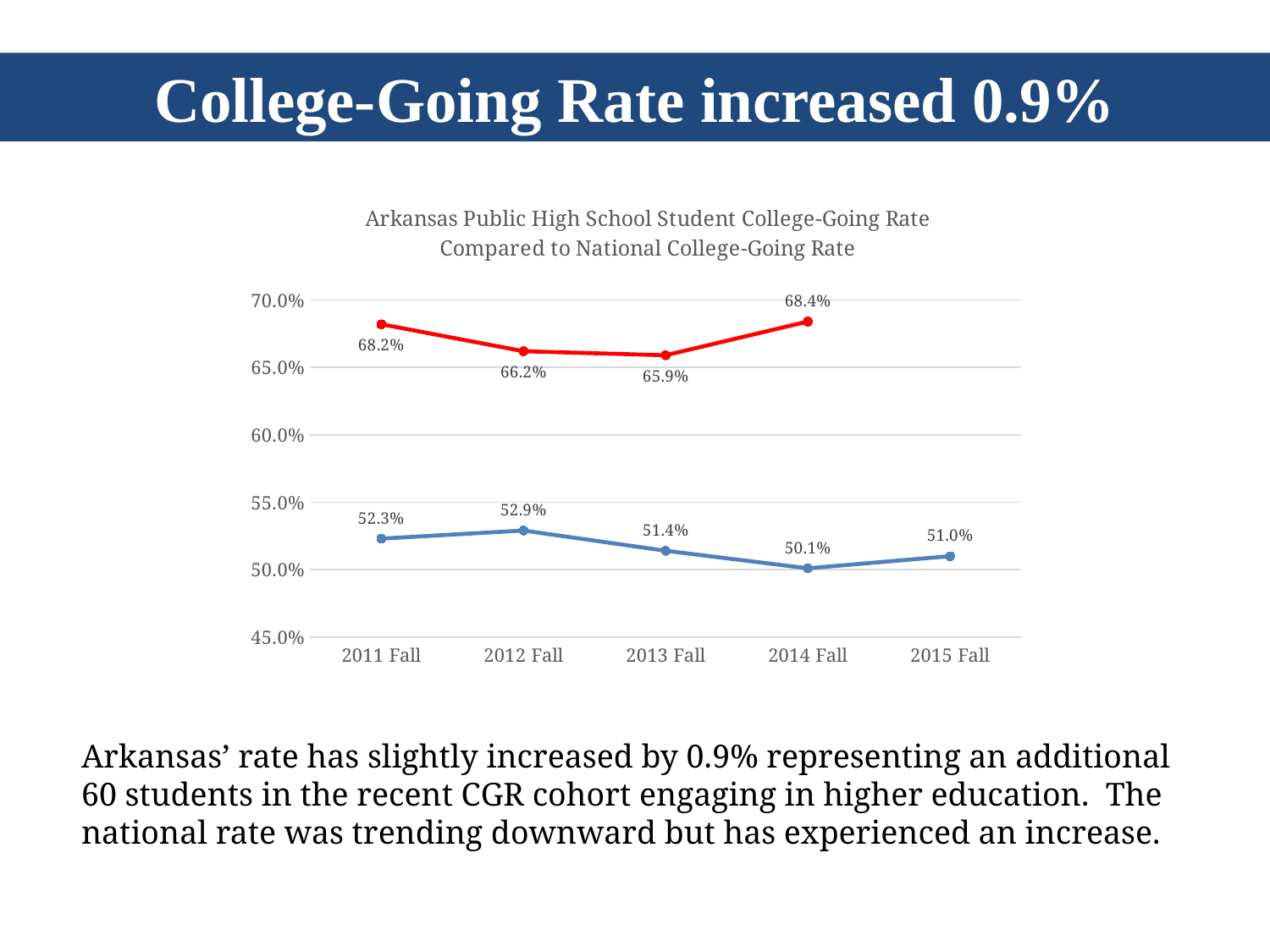
What is the difference between the red line's values for 2011 Fall and 2013 Fall? 2.3% In which year does the blue line reach its lowest value? 2014 Fall By how much did the blue line increase from 2014 Fall to 2015 Fall? 0.9% Does the blue line rise or fall from 2012 Fall to 2014 Fall? Fall In which year does the blue line reach its highest value? 2012 Fall Which is larger for the red line: the value for 2011 Fall or 2014 Fall? 2014 Fall How many data points are plotted on the blue line? 5 What is the value of the blue line for 2015 Fall? 51.0% How many data points are plotted on the red line? 4 What is the value of the blue line for 2014 Fall? 50.1% What is the value of the red line for 2012 Fall? 66.2% What kind of chart is shown on the slide? Line chart